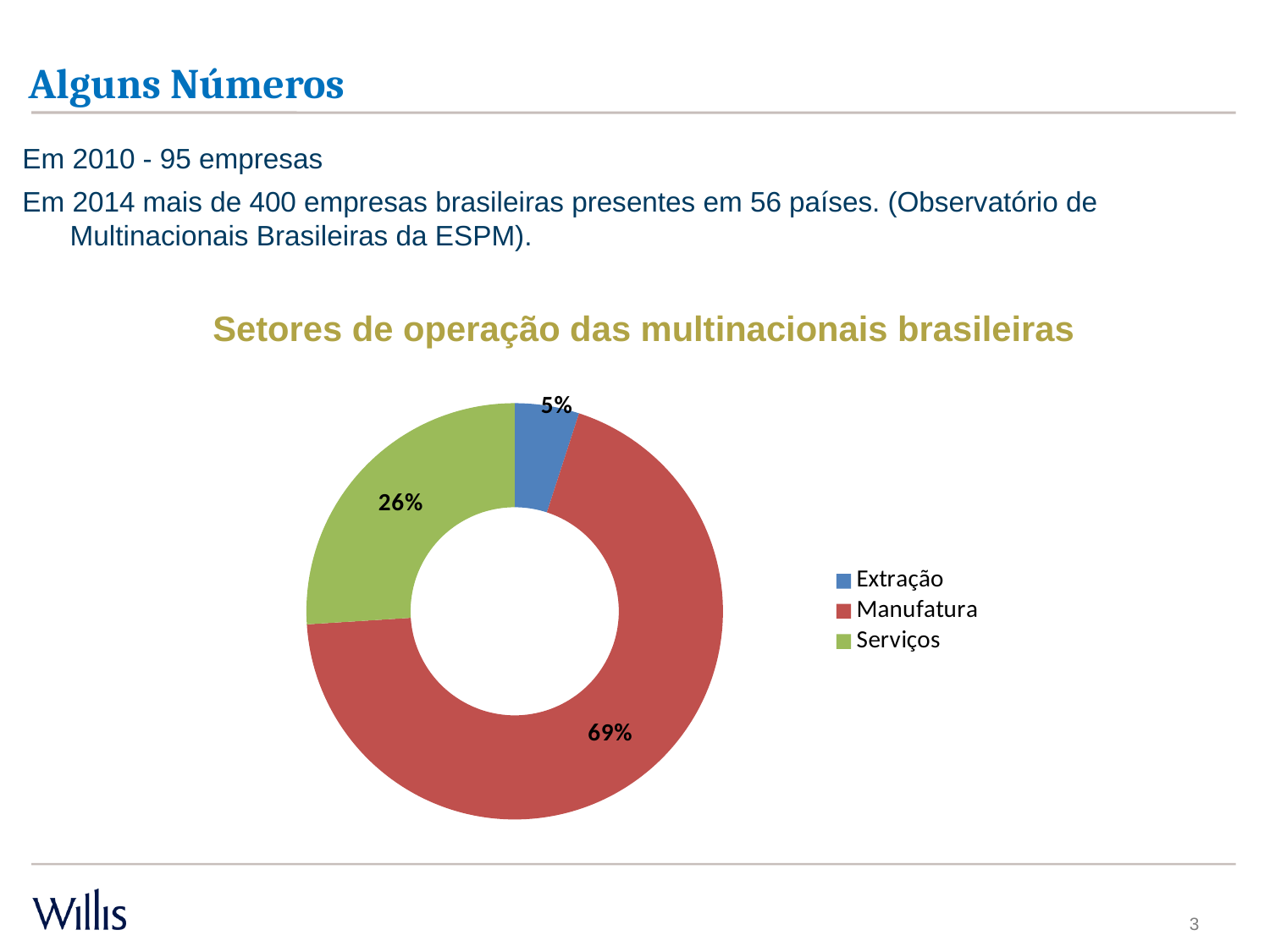
What is the difference in percentage points between Serviços and Extração? 21 Which sector has the smallest share? Extração What share of the pie does Extração represent? 5% What share of the pie does Manufatura represent? 69% How many sectors are shown in the chart? 3 What kind of chart is shown on the slide? Pie chart (doughnut) Which colour represents Manufatura in the chart? Red What is the title of the chart? Setores de operação das multinacionais brasileiras Which is larger, the share for Serviços or the share for Extração? Serviços What is the difference in percentage points between Manufatura and Serviços? 43 Which sector has the largest share? Manufatura What share of the pie does Serviços represent? 26%